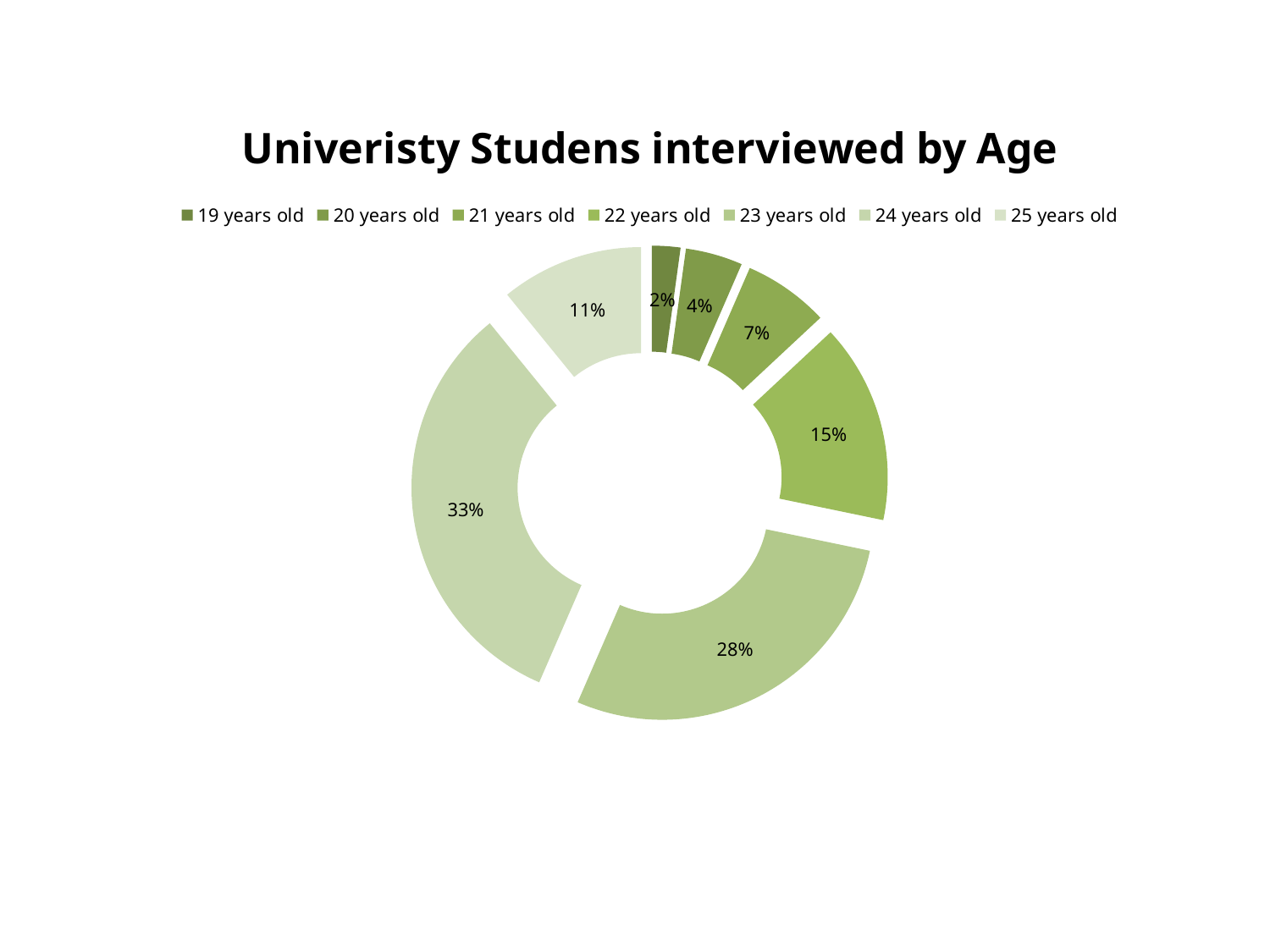
How many age groups are shown in the chart? 7 What is the difference in percentage points between the 23 years old and 22 years old groups? 13 What percentage of the interviewed students are 24 years old? 33% What share of the chart is taken by 22 years old students? 15% Which group has a larger share, 21 years old or 25 years old? 25 years old Which age group has the smallest share of the chart? 19 years old Which age group has the largest share of the chart? 24 years old What percentage is shown for 19 years old? 2% What is the combined share of the 19, 20 and 21 years old groups? 13% What kind of chart is shown on the slide? Doughnut chart What percentage is shown for 25 years old? 11% What is the title of the chart? Univeristy Studens interviewed by Age